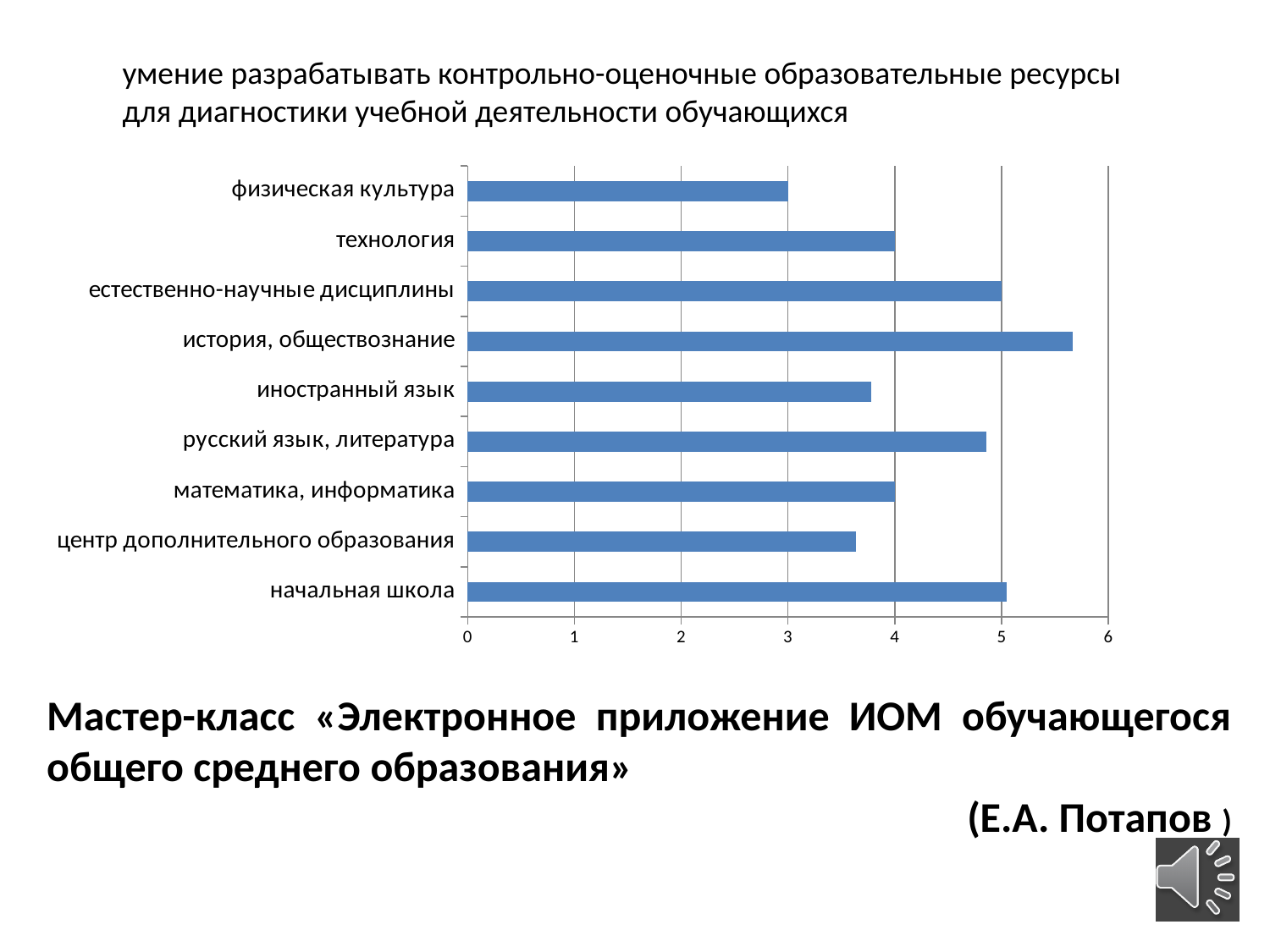
Which category has the lowest value in the chart? физическая культура Is the value for история, обществознание greater or less than 5? greater How many categories are plotted in the chart? 9 Is the value for центр дополнительного образования greater or less than 4? less What is the value for технология? 4 What type of chart is shown on the slide? bar chart What is the value for физическая культура? 3 Which is larger, the value for русский язык, литература or the value for иностранный язык? русский язык, литература What is the highest value shown on the horizontal axis of the chart? 6 Is the value for иностранный язык greater or less than 4? less What is the value for естественно-научные дисциплины? 5 Which category has the highest value in the chart? история, обществознание